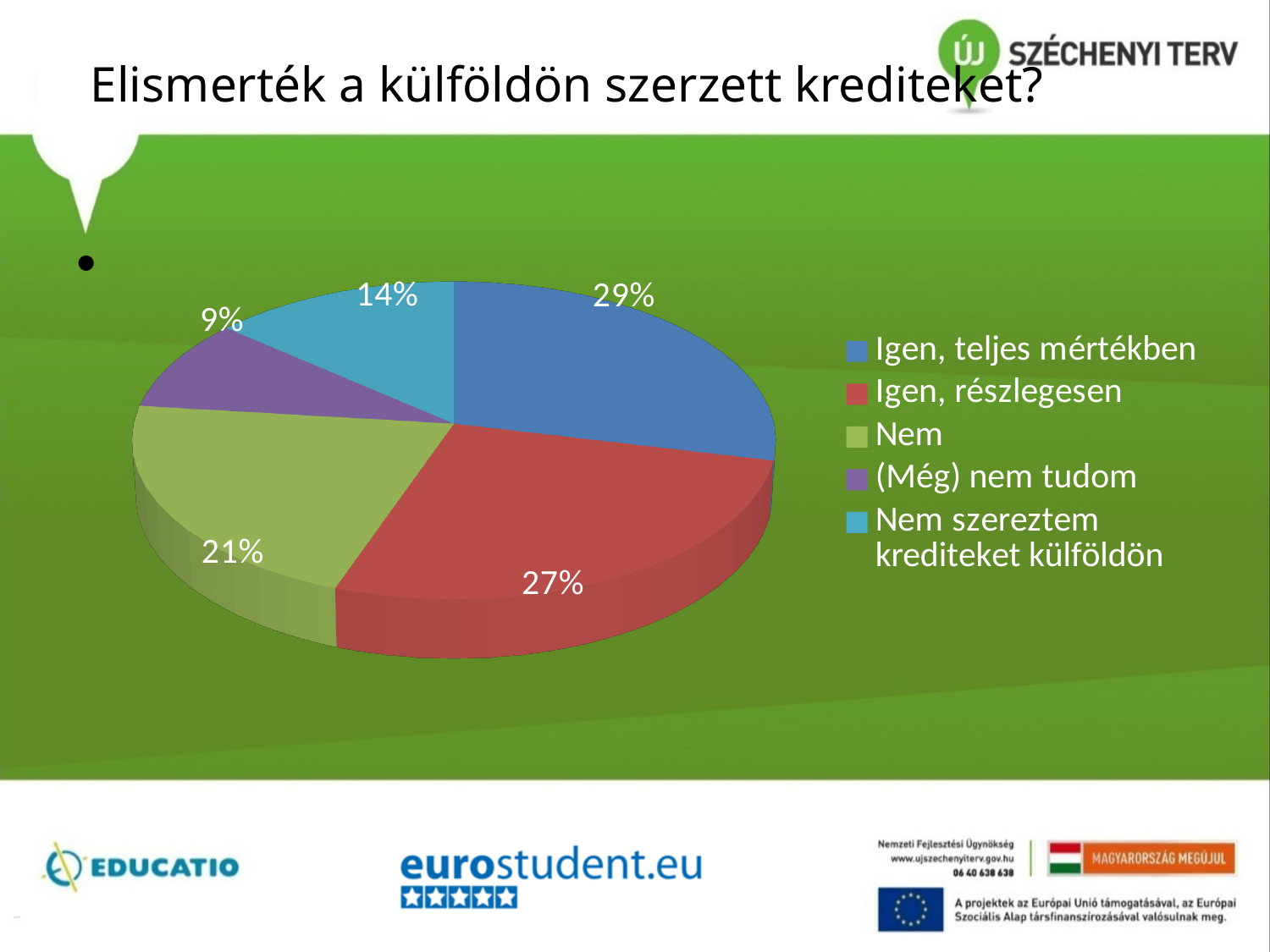
What share of the pie does "Nem szereztem krediteket külföldön" have? 14% Which category has the smallest slice of the pie? (Még) nem tudom What share of the pie does "Igen, részlegesen" have? 27% Which category has the largest slice of the pie? Igen, teljes mértékben What share of the pie does "Nem" have? 21% What is the title of the slide containing the pie chart? Elismerték a külföldön szerzett krediteket? What is the difference in percentage points between "Nem" and "(Még) nem tudom"? 12 How many slices does the pie chart have? 5 What kind of chart is shown on the slide? pie chart Which is larger, the slice for "Nem" or the slice for "Nem szereztem krediteket külföldön"? Nem